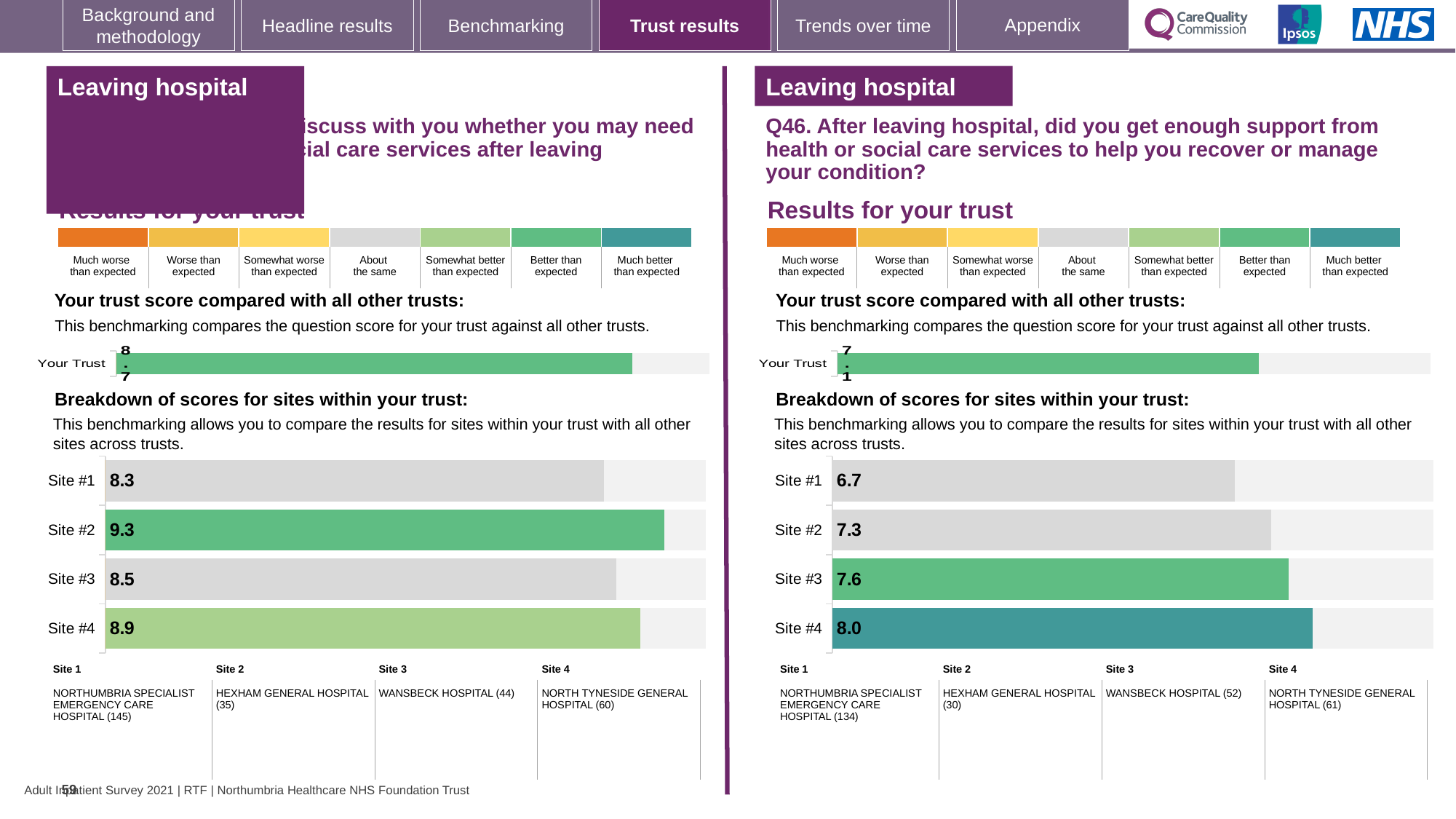
In the right-hand (Q46) site breakdown chart, do the scores rise or fall from Site #1 to Site #4? Rise In the left-hand 'Breakdown of scores for sites within your trust' chart, what is the score for Site #2? 9.3 In the left-hand site breakdown chart, what is the difference between the scores for Site #2 and Site #1? 1.0 In the left-hand site breakdown chart, which has the higher score, Site #3 or Site #4? Site #4 In the right-hand (Q46) site breakdown chart, what is the difference between the scores for Site #4 and Site #1? 1.3 In the left-hand site breakdown chart, which site has the highest score? Site #2 What kind of chart is used for the site breakdown on the left-hand side of the slide? Bar chart In the right-hand (Q46) 'Your trust score compared with all other trusts' chart, what is the score for Your Trust? 7.1 In the right-hand (Q46) site breakdown chart, which has the higher score, Site #2 or Site #3? Site #3 In the right-hand (Q46) 'Breakdown of scores for sites within your trust' chart, what is the score for Site #4? 8.0 In the right-hand (Q46) site breakdown chart, which site has the lowest score? Site #1 How many sites are shown in the right-hand (Q46) site breakdown chart? 4